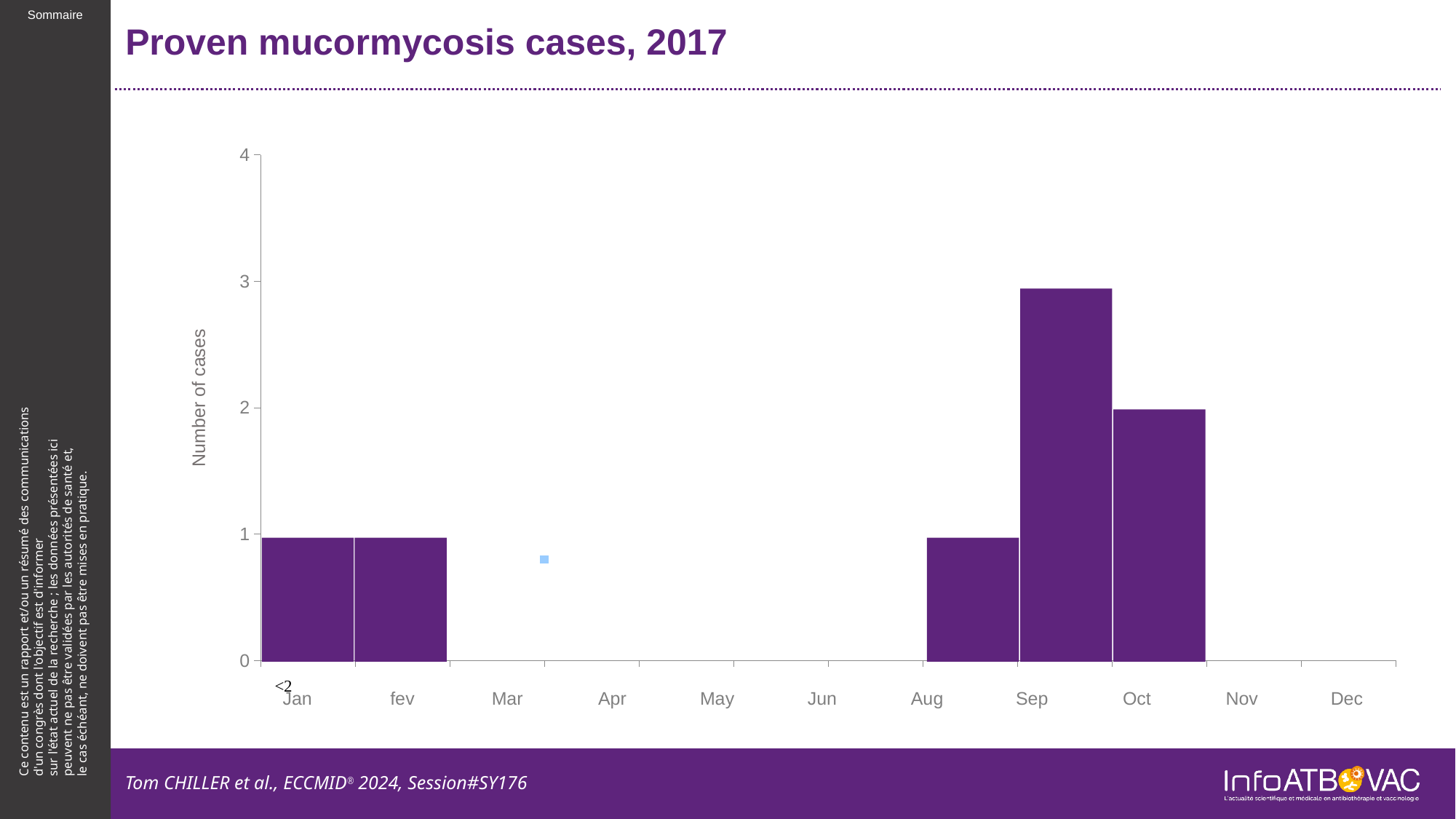
Do the values rise or fall from Sep to Oct? fall How many month categories are shown on the x axis? 11 Is the value for Aug greater or less than 2? less Which is larger, the value for Sep or the value for Oct? Sep What is the title of the chart? Proven mucormycosis cases, 2017 Which is larger, the value for Oct or the value for Aug? Oct Is the value for Sep greater or less than 2? greater Which month has the highest number of cases? Sep What is the label of the vertical axis? Number of cases Is the value for Jan greater or less than 2? less What kind of chart is shown on the slide? bar chart